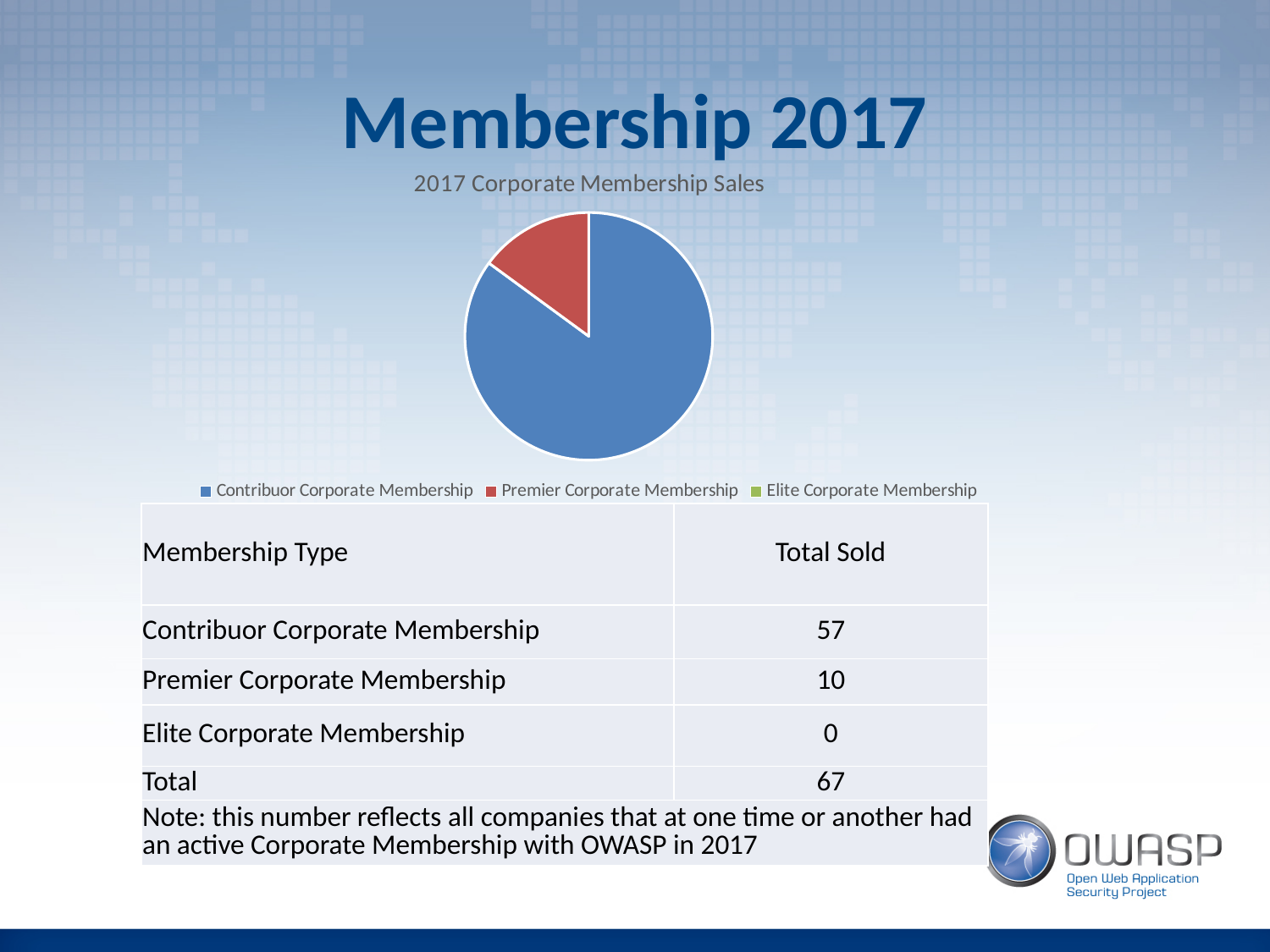
Which membership type has the smallest value? Elite Corporate Membership What is the total number of corporate memberships sold in 2017? 67 What is the title of the chart? 2017 Corporate Membership Sales Which sold more: Contribuor Corporate Membership or Premier Corporate Membership? Contribuor Corporate Membership What colour represents Premier Corporate Membership in the pie chart? red What is the difference between Contribuor Corporate Membership and Premier Corporate Membership sales? 47 How many Elite Corporate Memberships were sold in 2017? 0 How many Contribuor Corporate Memberships were sold in 2017? 57 How many membership types does the chart legend list? 3 How many Premier Corporate Memberships were sold in 2017? 10 What kind of chart is shown on the slide? pie chart Which membership type has the largest slice of the pie? Contribuor Corporate Membership